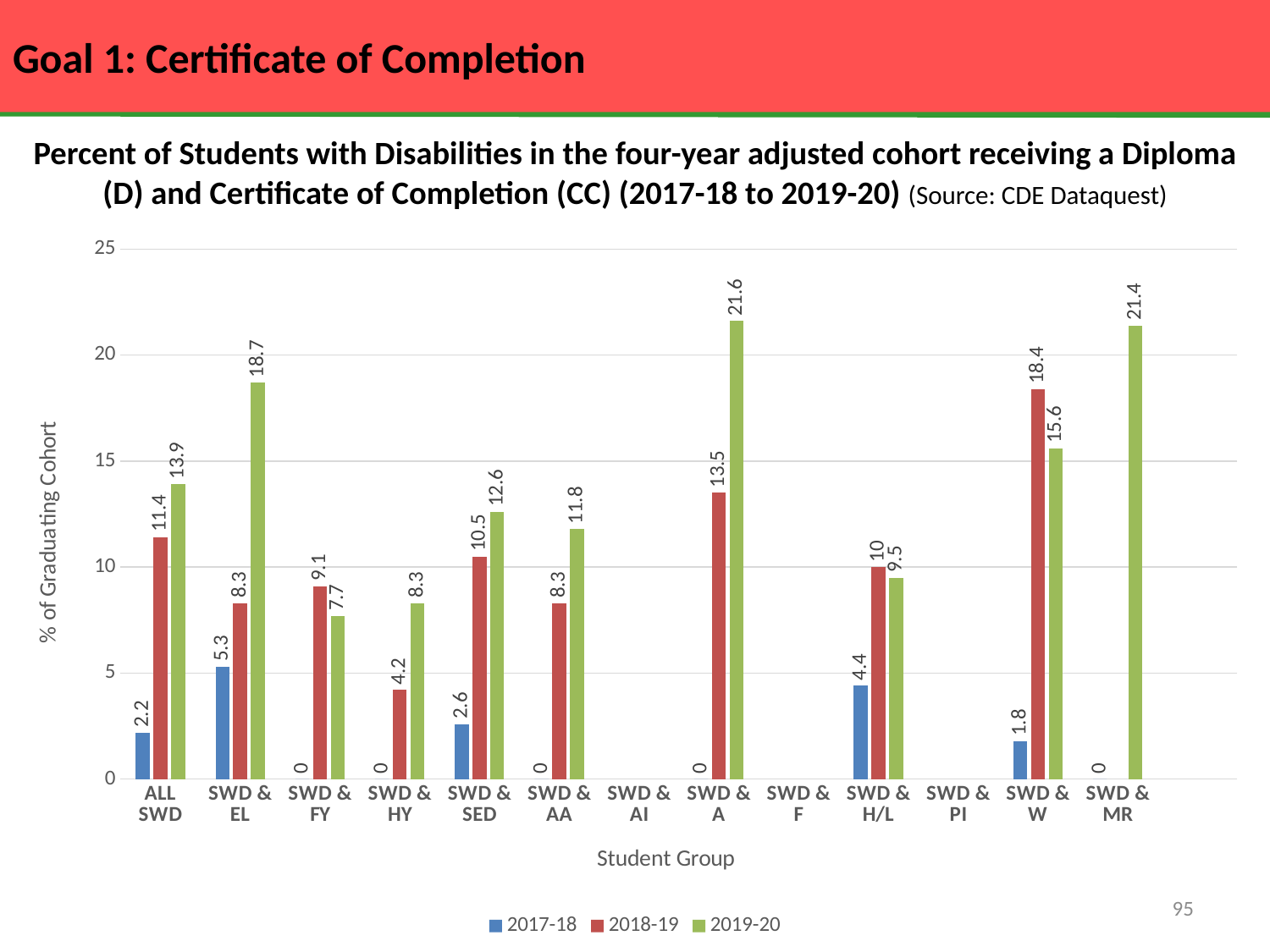
For SWD & H/L, which is larger: the 2018-19 value or the 2019-20 value? 2018-19 What is the label on the y axis? % of Graduating Cohort Which student group has the highest 2019-20 value? SWD & A How many student groups are shown on the x axis? 13 How many series does the legend list? 3 Which student group has the highest 2018-19 value? SWD & W What is the 2019-20 value for SWD & A? 21.6 Is the 2019-20 value for SWD & EL greater or less than 15? greater What is the 2018-19 value for SWD & W? 18.4 What is the 2017-18 value for SWD & EL? 5.3 What is the difference between the 2019-20 and 2018-19 values for ALL SWD? 2.5 What kind of chart is shown on the slide? bar chart